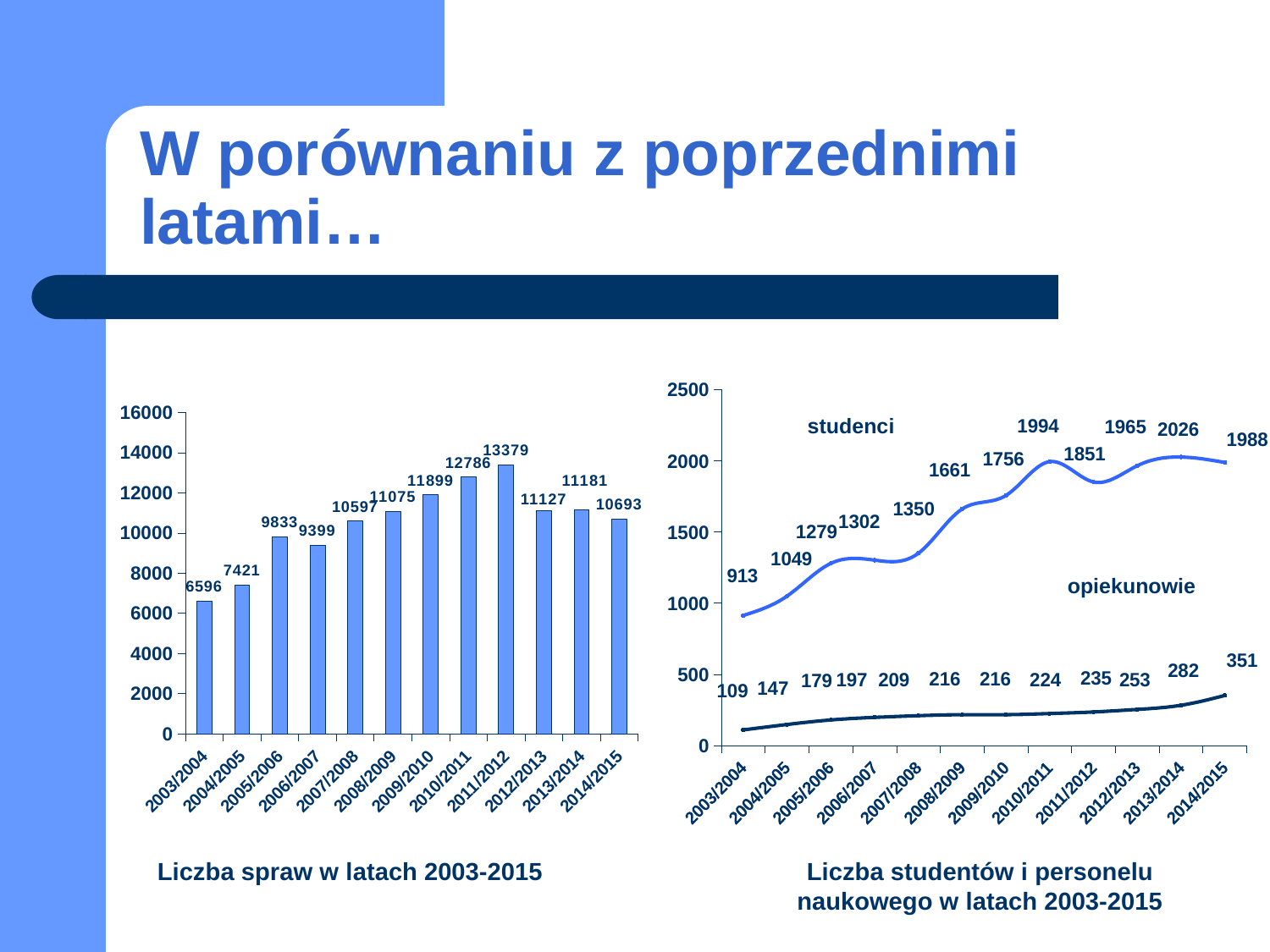
In the left chart (Liczba spraw w latach 2003-2015), what is the difference between the values for 2010/2011 and 2009/2010? 887 In the right chart (Liczba studentów i personelu naukowego), what is the value for opiekunowie in 2014/2015? 351 In the left chart (Liczba spraw w latach 2003-2015), what is the value for 2011/2012? 13379 In the left chart (Liczba spraw w latach 2003-2015), which year has the highest value? 2011/2012 In the right chart (Liczba studentów i personelu naukowego), how many series are plotted? 2 In the right chart (Liczba studentów i personelu naukowego), what is the value for studenci in 2013/2014? 2026 In the right chart (Liczba studentów i personelu naukowego), what is the difference between studenci and opiekunowie in 2003/2004? 804 In the left chart (Liczba spraw w latach 2003-2015), which year has the lowest value? 2003/2004 In the right chart (Liczba studentów i personelu naukowego), does the opiekunowie series generally rise or fall from 2003/2004 to 2014/2015? rise In the left chart (Liczba spraw w latach 2003-2015), how many years are shown on the x axis? 12 In the right chart (Liczba studentów i personelu naukowego), which series has the higher value in 2008/2009, studenci or opiekunowie? studenci What kind of chart is the left chart (Liczba spraw w latach 2003-2015)? bar chart